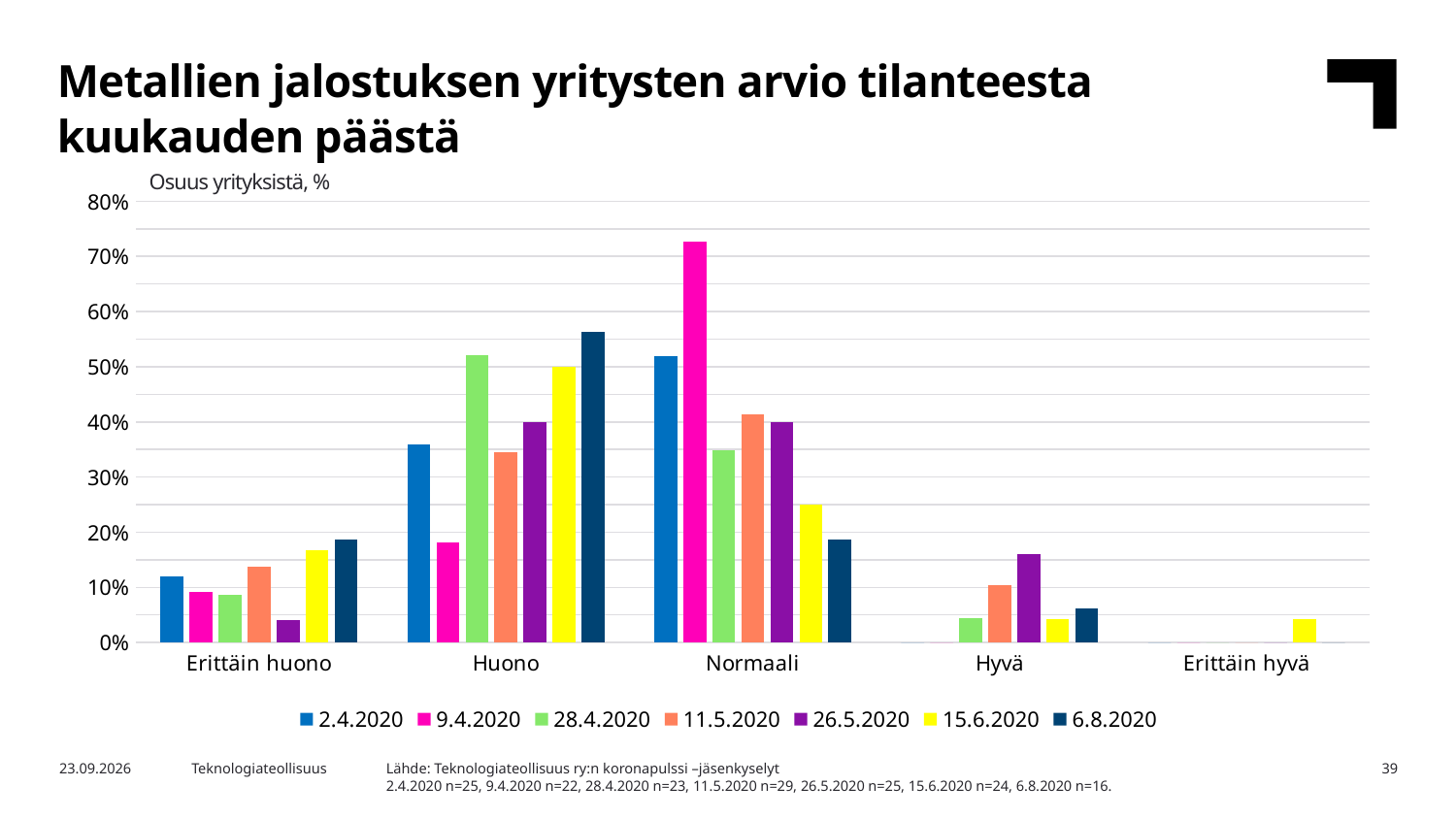
Is the value for 15.6.2020 in the Normaali category greater or less than 30%? less Is the value for 9.4.2020 in the Normaali category greater or less than 70%? greater In the Huono category, which is larger: the 28.4.2020 bar or the 2.4.2020 bar? 28.4.2020 Is the value for 6.8.2020 in the Huono category greater or less than 50%? greater How many categories are shown on the x axis? 5 For the 9.4.2020 series, which category has the highest bar? Normaali In the Erittäin huono category, which series has the lowest bar? 26.5.2020 What kind of chart is shown on the slide? bar chart In the Normaali category, which is larger: the 2.4.2020 bar or the 6.8.2020 bar? 2.4.2020 How many series does the legend list? 7 What is the label shown above the vertical axis of the chart? Osuus yrityksistä, %